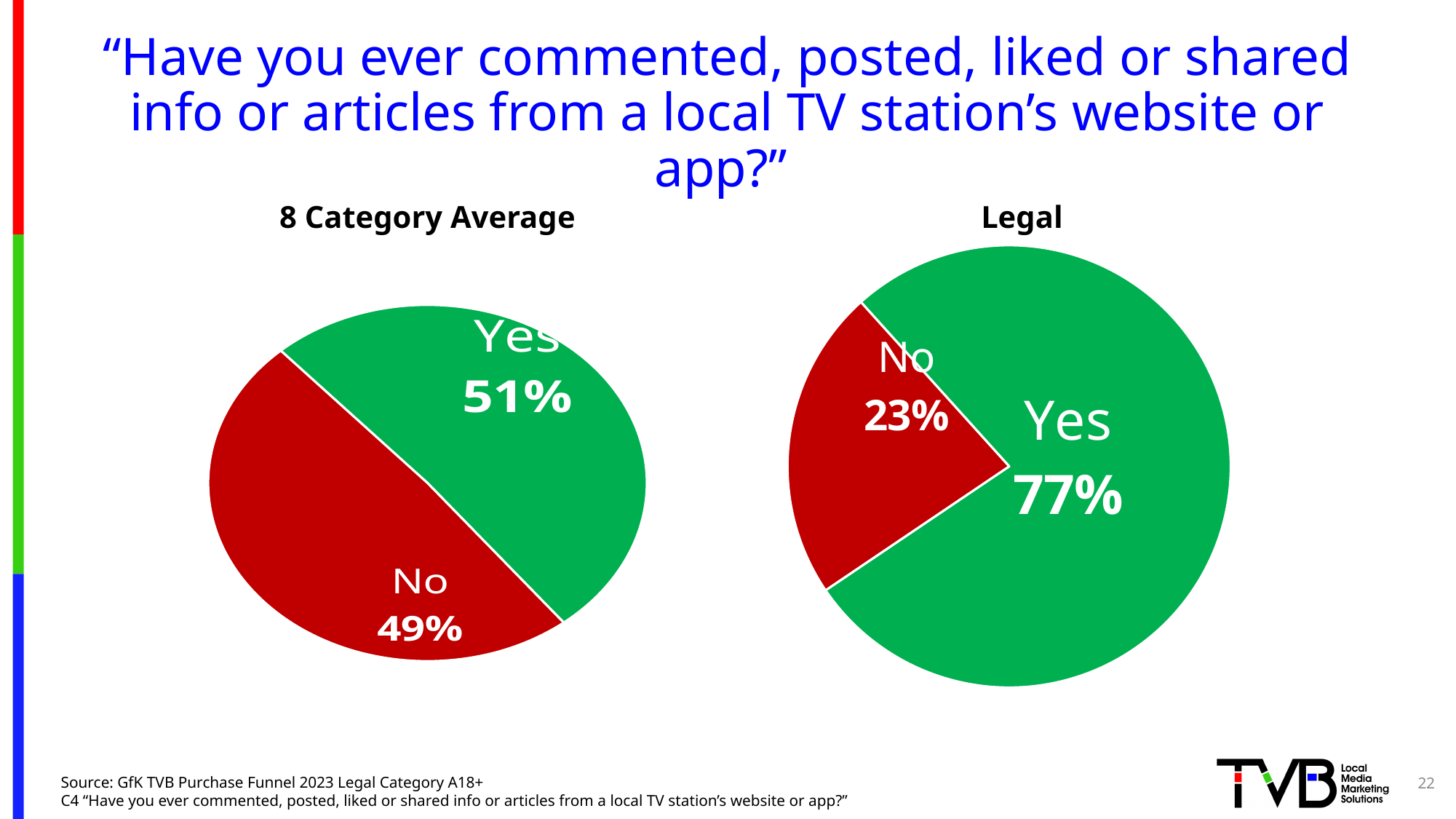
In the 'Legal' pie chart, what colour is the Yes slice? Green In the 'Legal' pie chart, which slice is the smallest? No In the '8 Category Average' pie chart, what is the difference between the Yes and No percentages? 2% In the '8 Category Average' pie chart, what percentage answered Yes? 51% What type of chart is used for the '8 Category Average'? Pie chart Is the Yes share larger in the 'Legal' chart or in the '8 Category Average' chart? Legal In the '8 Category Average' pie chart, what percentage answered No? 49% In the 'Legal' pie chart, what percentage answered Yes? 77% How many slices does the 'Legal' pie chart have? 2 In the 'Legal' pie chart, what is the difference between the Yes and No percentages? 54% In the 'Legal' pie chart, what percentage answered No? 23% In the 'Legal' pie chart, which slice is the largest? Yes